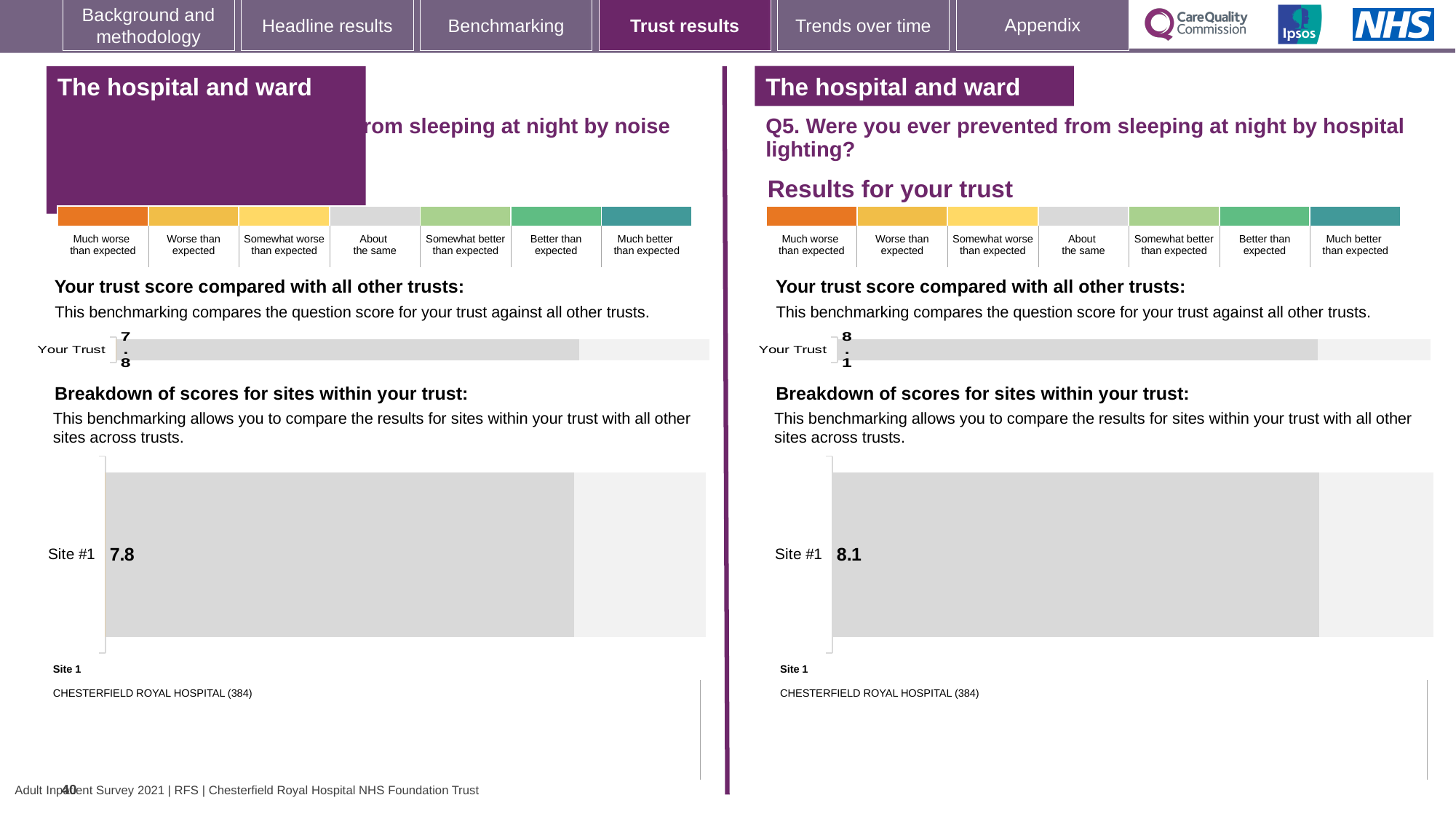
What kind of chart is used to show the Your Trust score on this slide? bar chart In the left-hand 'Breakdown of scores for sites within your trust' chart, what is the score for Site #1? 7.8 Which hospital is listed as Site 1 beneath the breakdown charts? CHESTERFIELD ROYAL HOSPITAL (384) What is the difference between the Your Trust score in the right-hand chart (8.1) and the Your Trust score in the left-hand chart (7.8)? 0.3 How many rating categories are shown in the colour scale above the right-hand charts, from 'Much worse than expected' to 'Much better than expected'? 7 In the left-hand 'Your trust score compared with all other trusts' chart, what is the score for Your Trust? 7.8 In the right-hand 'Your trust score compared with all other trusts' chart (Q5, hospital lighting), what is the score for Your Trust? 8.1 Which half of the slide shows the higher Your Trust score, the left-hand chart (noise) or the right-hand chart (Q5, hospital lighting)? the right-hand chart (Q5, hospital lighting) In the right-hand 'Breakdown of scores for sites within your trust' chart (Q5, hospital lighting), what is the score for Site #1? 8.1 How many sites are shown in the right-hand 'Breakdown of scores for sites within your trust' chart? 1 In the right-hand breakdown chart (Q5, hospital lighting), is the Site #1 score the same as the Your Trust score? yes